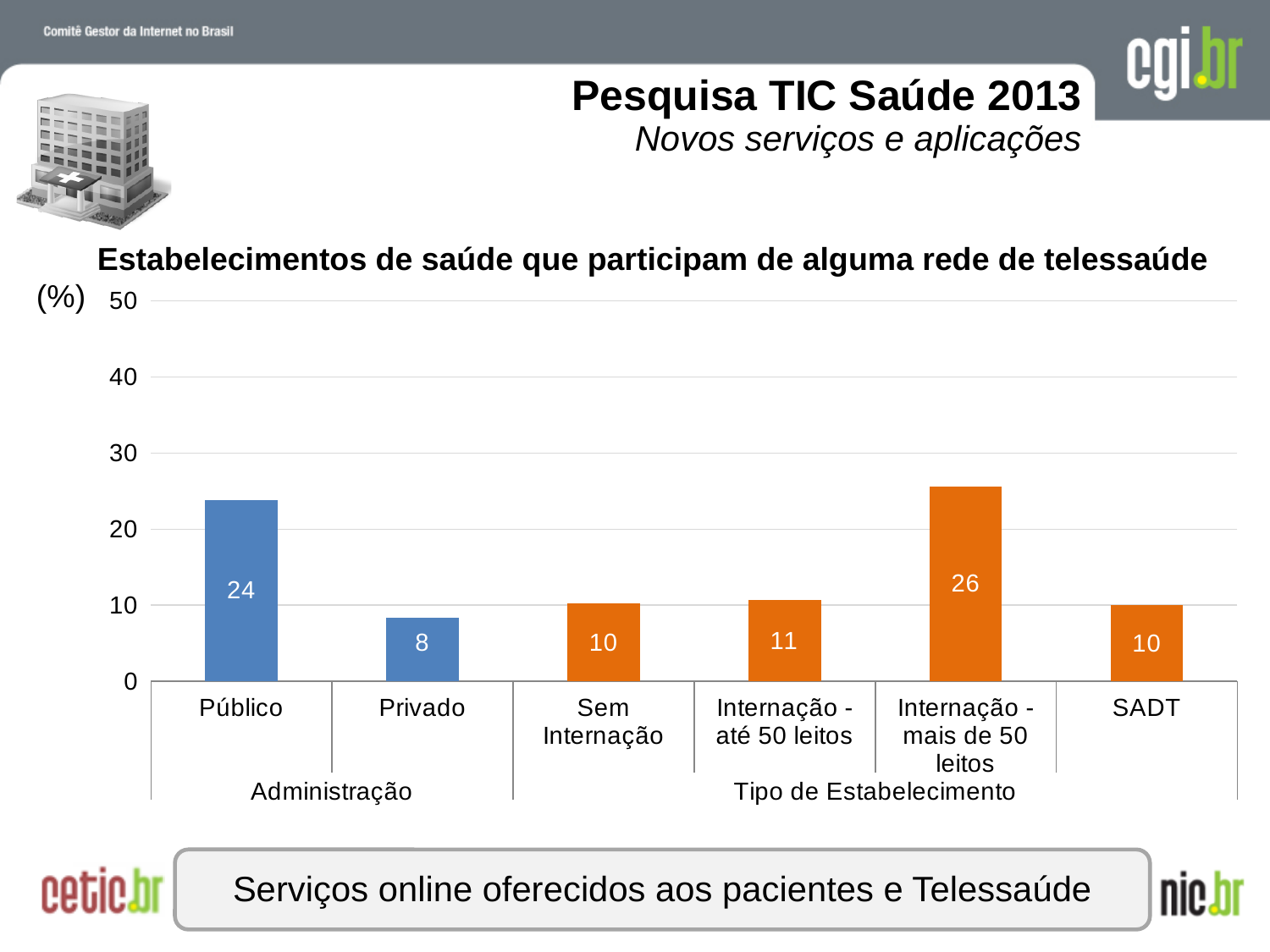
Which category has the highest value? Internação - mais de 50 leitos Which two categories are grouped under Administração? Público and Privado Which is larger, the value for Público or the value for Internação - mais de 50 leitos? Internação - mais de 50 leitos What is the value for Internação - mais de 50 leitos? 26 What is the value for Público? 24 What is the difference between the values for Público and Privado? 16 What kind of chart is shown on the slide? bar chart Is the value for Internação - até 50 leitos greater or less than 20? less How many categories are shown in the chart? 6 What is the value for Privado? 8 Which category has the lowest value? Privado What is the title of the chart? Estabelecimentos de saúde que participam de alguma rede de telessaúde